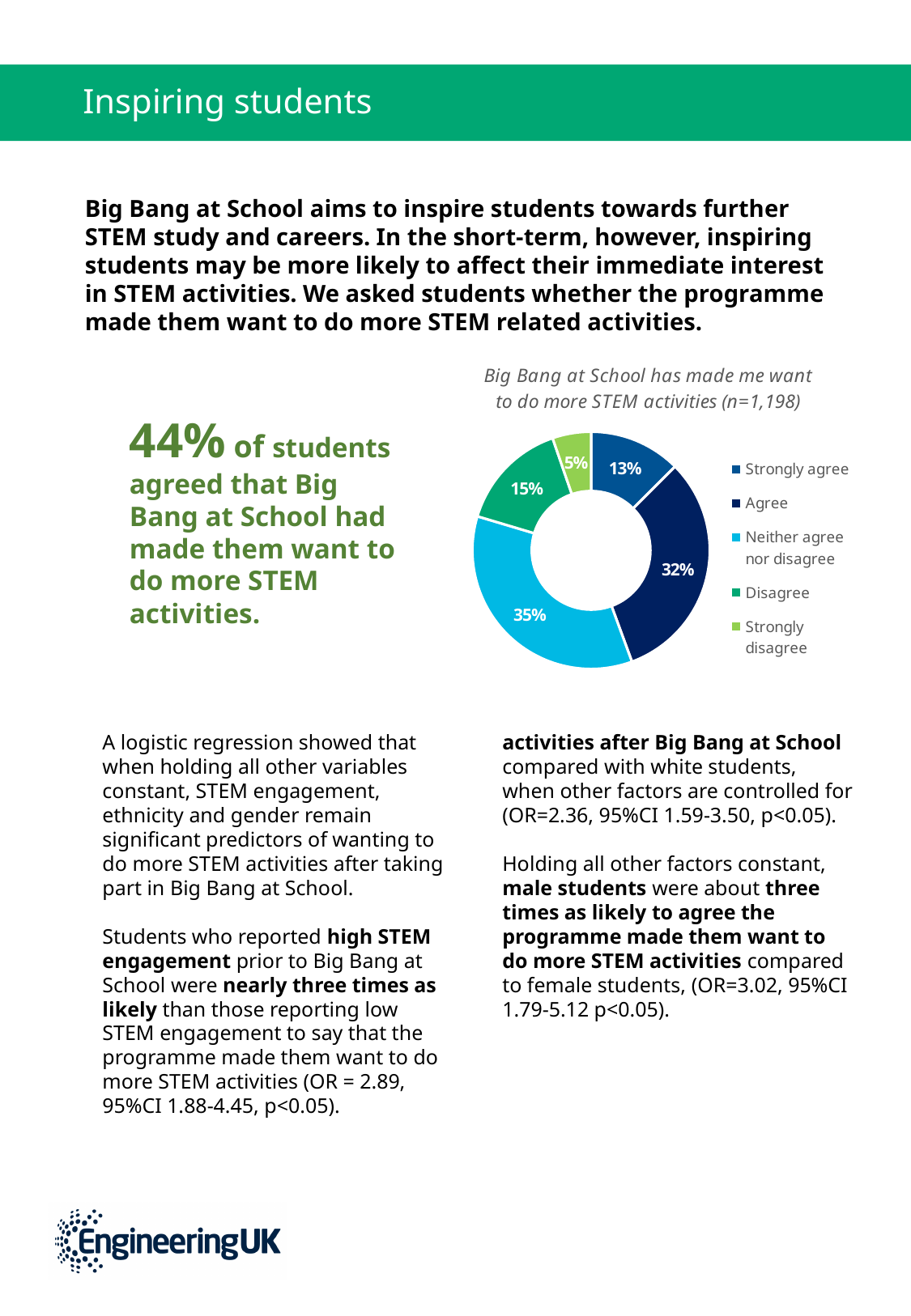
What is the difference in percentage points between 'Agree' and 'Strongly agree'? 19 What percentage of students selected 'Agree'? 32% What percentage of students selected 'Strongly agree'? 13% What type of chart is shown on the slide? Doughnut chart How many response categories does the chart show? 5 Which response category has the largest share in the chart? Neither agree nor disagree What is the combined share of 'Strongly agree' and 'Agree'? 45% What is the sample size (n) given in the chart title? 1,198 Which response category has the smallest share in the chart? Strongly disagree What percentage of students selected 'Neither agree nor disagree' in the chart? 35% Which is larger, the share for 'Disagree' or the share for 'Strongly disagree'? Disagree What percentage of students selected 'Disagree'? 15%